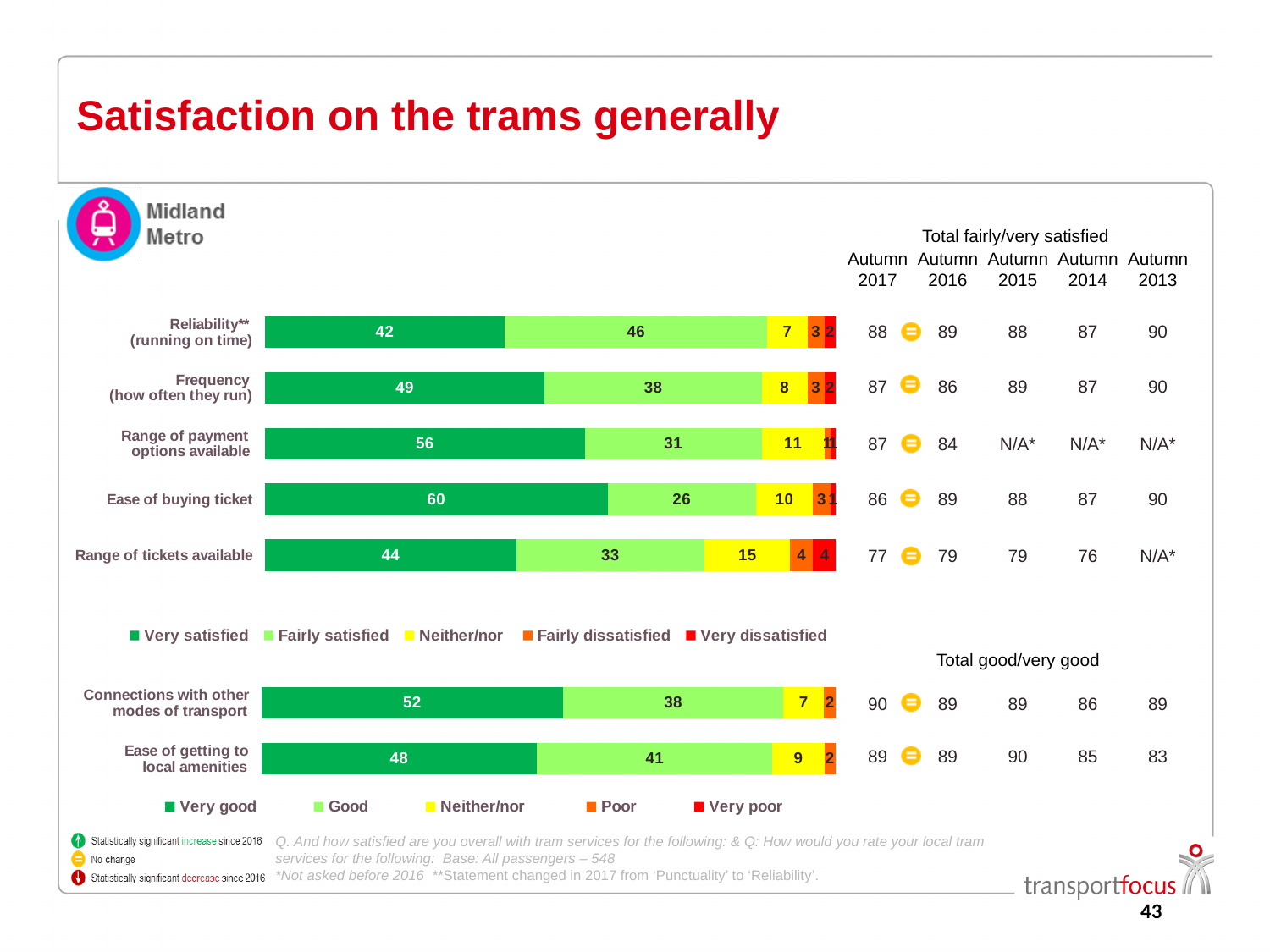
In the top chart (satisfaction), which has the larger Fairly satisfied value: Reliability or Frequency? Reliability In the top chart (satisfaction), which category has the highest Very satisfied value? Ease of buying ticket In the top chart (satisfaction), what is the Neither/nor value for Range of tickets available? 15 In the top chart (satisfaction), what is the difference between the Very satisfied values for Frequency and Reliability? 7 In the top chart (satisfaction), what is the Very satisfied value for Ease of buying ticket? 60 What kind of chart is used on this slide? Stacked bar chart In the bottom chart (good/very good), what is the Good value for Ease of getting to local amenities? 41 How many categories are plotted in the top chart (satisfaction)? 5 In the top chart (satisfaction), which category has the lowest Fairly satisfied value? Ease of buying ticket In the bottom chart (good/very good), which category has the larger Very good value: Connections with other modes of transport or Ease of getting to local amenities? Connections with other modes of transport How many series does the legend of the top chart (satisfaction) list? 5 In the top chart (satisfaction), what colour represents Very satisfied in the legend? Dark green